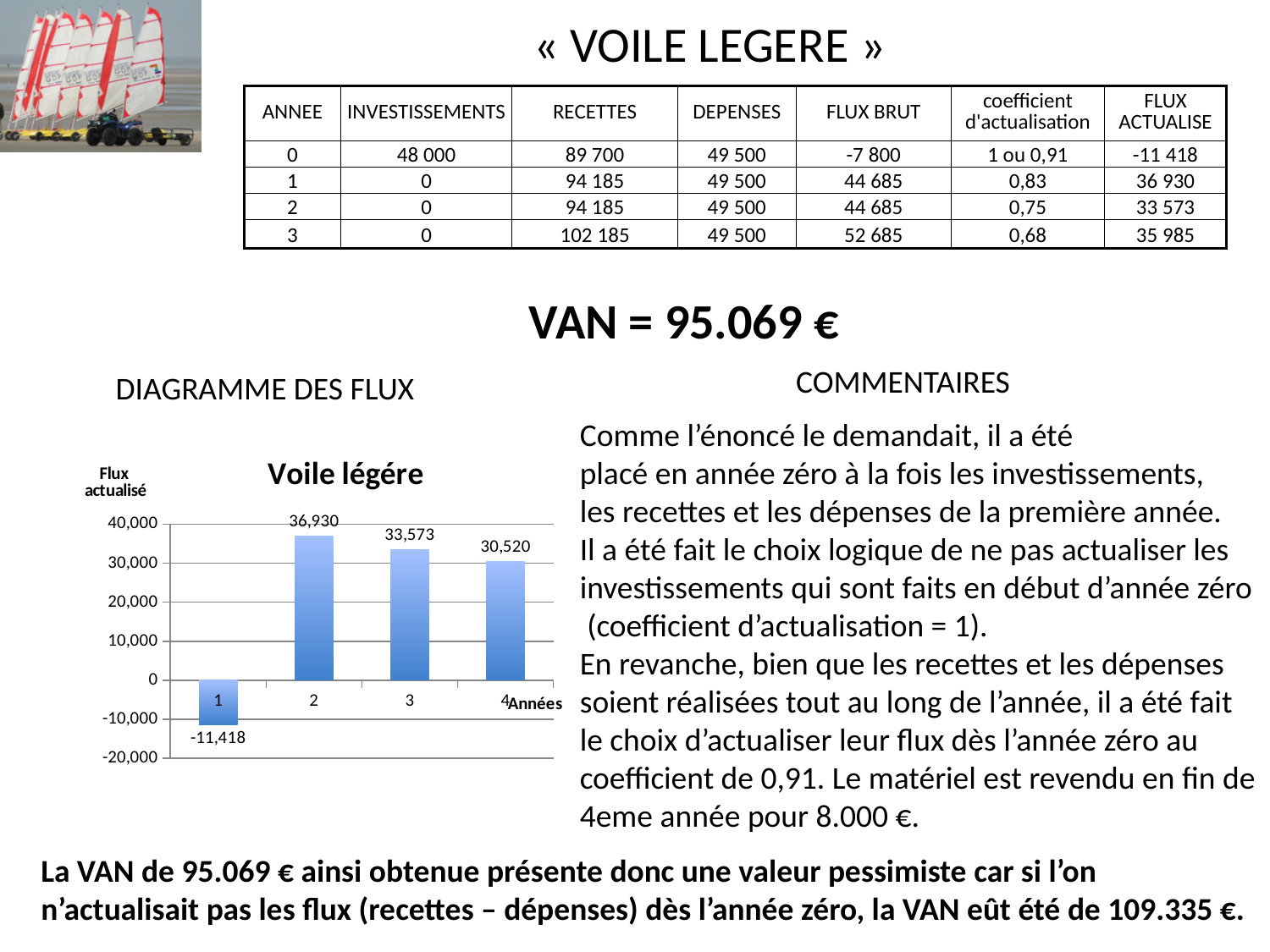
Which category has the lowest value in the chart? 1 What is the difference between the values for categories 2 and 3? 3,357 What is the value for category 4 in the chart? 30,520 Do the values rise or fall from category 2 to category 4? fall What is the value for category 3 in the chart? 33,573 How many bars are plotted in the chart? 4 Which is larger, the value for category 3 or category 4? category 3 What type of chart is shown under 'DIAGRAMME DES FLUX'? bar chart What is the value for category 2 in the chart? 36,930 Which category has the highest value in the chart? 2 What is the title of the chart? Voile légére What is the value for category 1 in the chart? -11,418